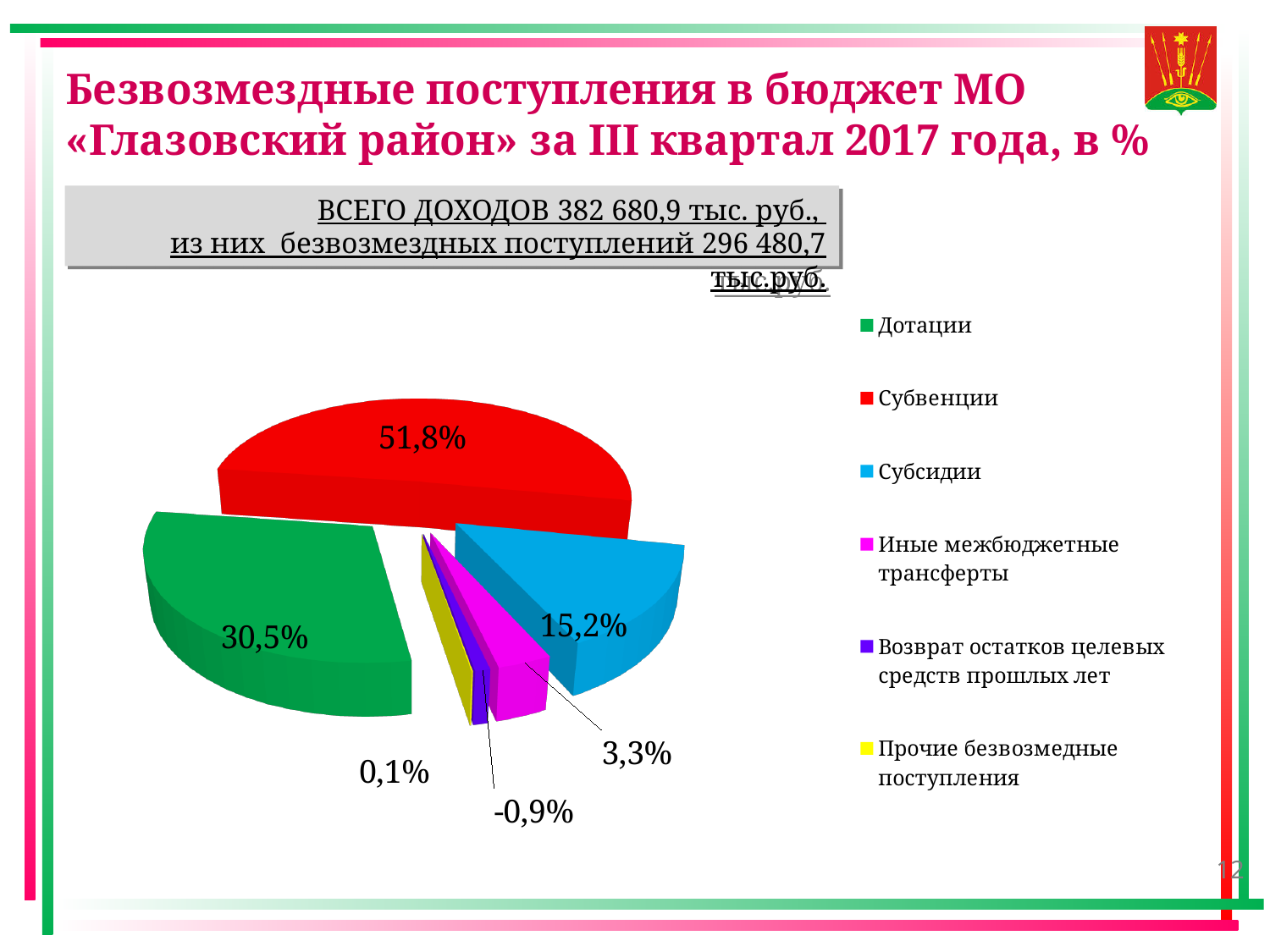
Which category has the largest share of the pie? Субвенции What is the value shown for Иные межбюджетные трансферты? 3,3% What kind of chart is shown on the slide? Pie chart What is the value shown for Возврат остатков целевых средств прошлых лет? -0,9% What share of the pie does Субвенции have? 51,8% What is the value shown for Дотации? 30,5% What is the value shown for Прочие безвозмедные поступления? 0,1% What is the difference between the values for Субвенции and Дотации? 21,3% Which category has the smallest value in the chart? Возврат остатков целевых средств прошлых лет How many categories does the legend list? 6 What is the value shown for Субсидии? 15,2% Which is larger, the value for Субсидии or the value for Иные межбюджетные трансферты? Субсидии